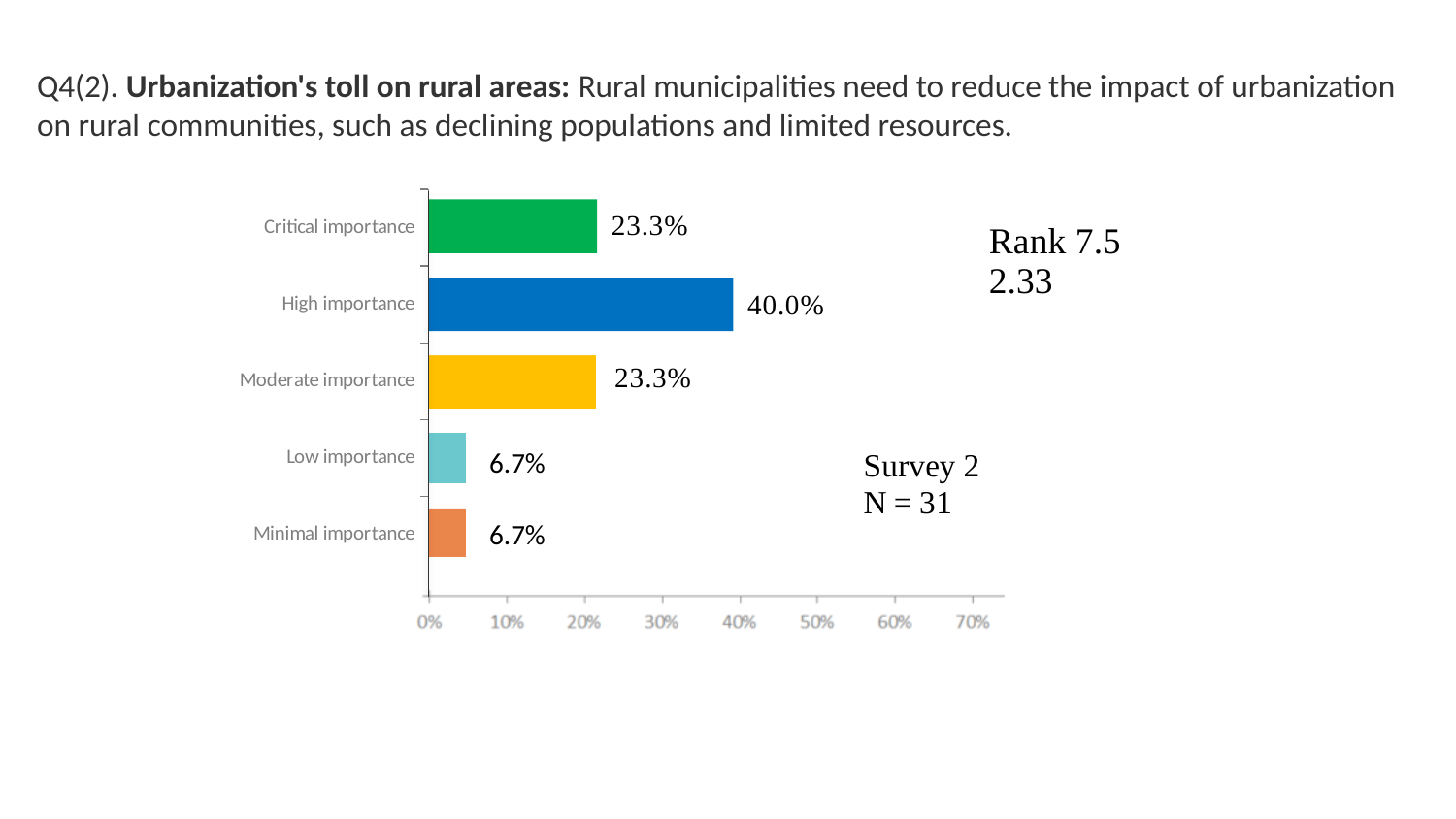
What is the value for Critical importance? 23.3% What kind of chart is shown on the slide? Bar chart Is the value for Minimal importance greater or less than 10%? less What is the difference between the values for High importance and Moderate importance? 16.7% What is the value for Low importance? 6.7% How many categories are shown in the chart? 5 Is the value for High importance greater or less than 30%? greater What is the highest value shown on the x axis? 70% Which is larger, the value for Critical importance or the value for Low importance? Critical importance What is the value for High importance? 40.0% Which category has the highest value? High importance What colour is the bar for High importance? Blue